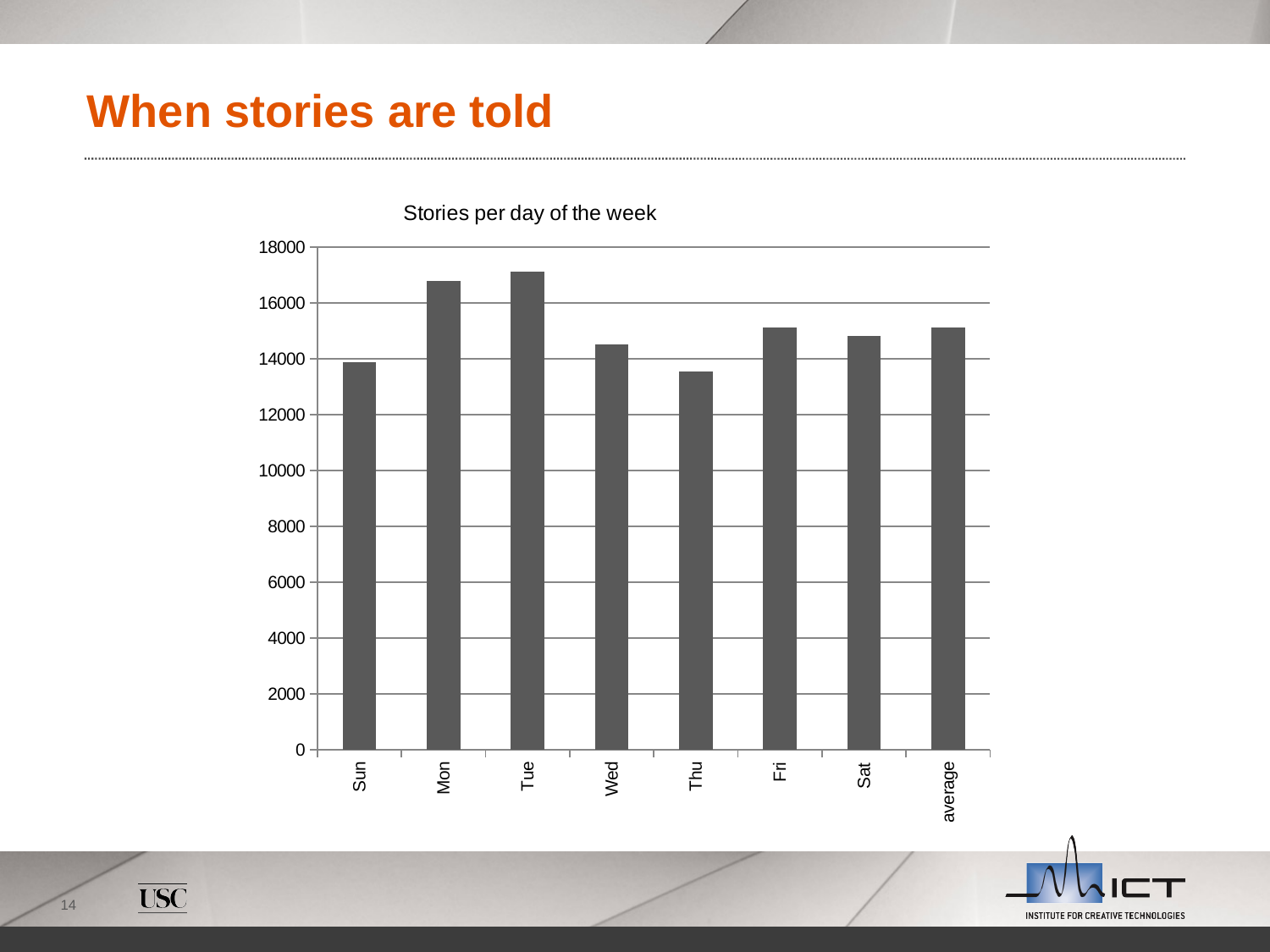
Is the value for Thu greater or less than 14000? less Which day of the week has the highest number of stories? Tue Which has more stories, Mon or Wed? Mon Is the value for Mon greater or less than 16000? greater Which has more stories, Thu or Fri? Fri Is the value for Sat greater or less than 16000? less How many categories are shown on the x axis of the chart? 8 What is the label of the last category on the x axis? average Which day of the week has the lowest number of stories? Thu What is the title of the chart? Stories per day of the week What kind of chart is shown on the slide? bar chart